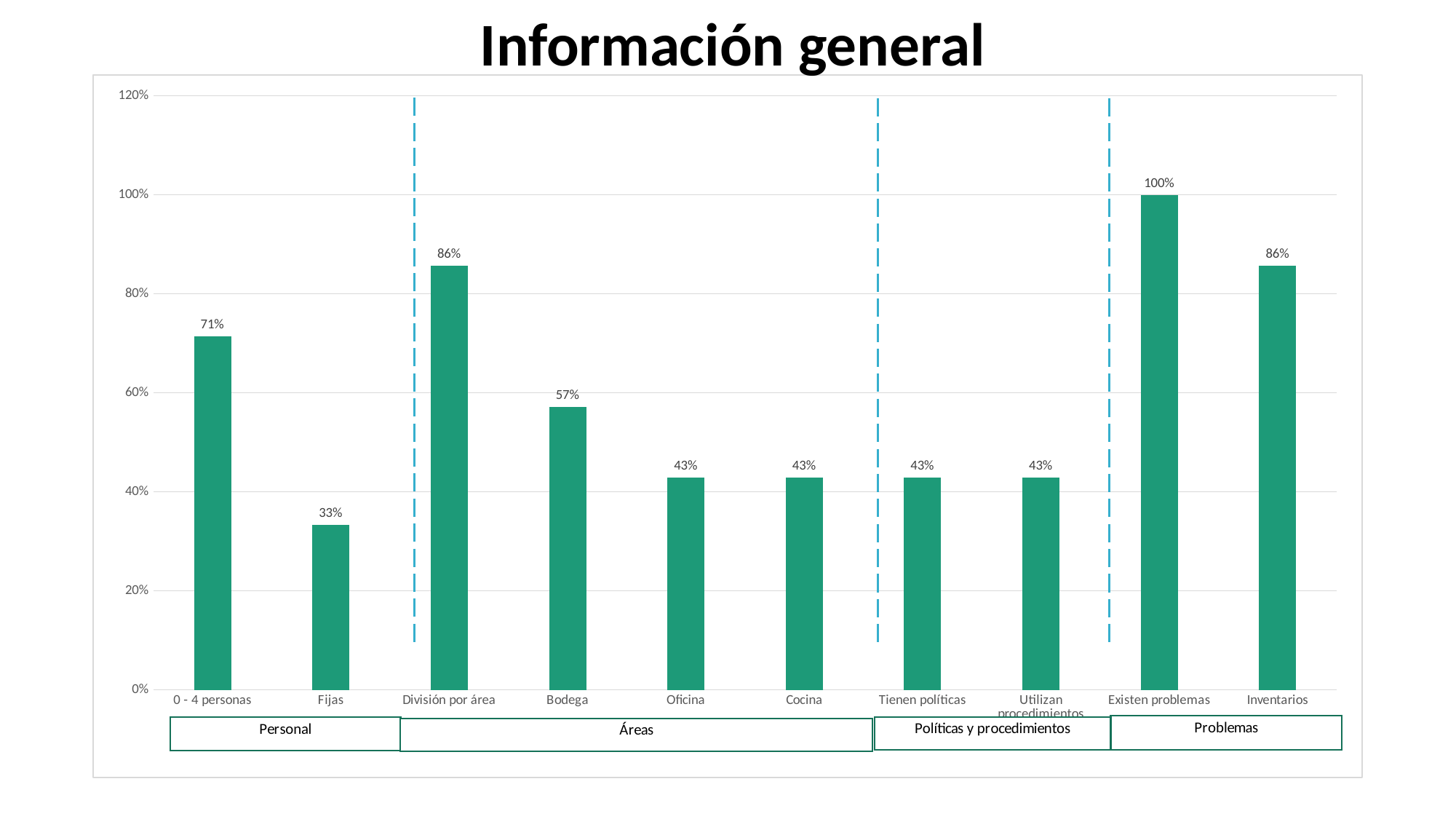
What is the value for 0 - 4 personas? 71% Is the value for Oficina greater or less than 60%? less Which category has the highest value? Existen problemas What is the title of the slide? Información general What is the value for Fijas? 33% Which is larger, the value for Inventarios or the value for 0 - 4 personas? Inventarios What is the value for Bodega? 57% How many categories are shown on the x axis? 10 What kind of chart is shown on the slide? bar chart How many groups are labelled in the boxes below the x axis? 4 What is the difference between the values for División por área and Bodega? 29% Which category has the lowest value? Fijas